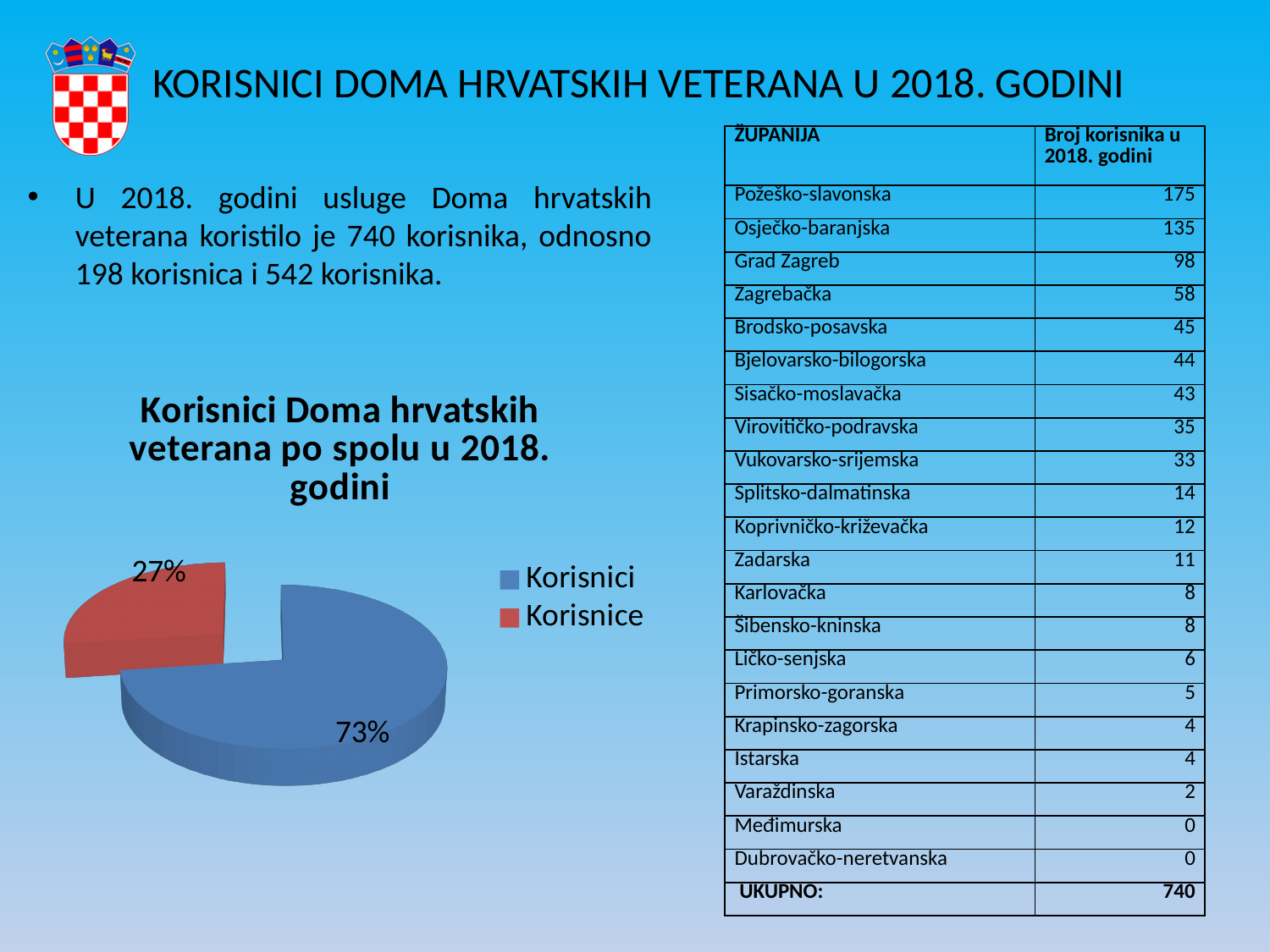
How many entries does the legend of the pie chart list? 2 What colour is the Korisnice slice in the pie chart? red What is the title of the pie chart? Korisnici Doma hrvatskih veterana po spolu u 2018. godini Which is larger in the pie chart, Korisnici or Korisnice? Korisnici Which slice of the pie chart is the smallest? Korisnice What is the difference in percentage points between the Korisnici and Korisnice slices? 46 What kind of chart is shown on the slide? pie chart How many slices does the pie chart have? 2 What share of the pie does Korisnice have? 27% What share of the pie does Korisnici have? 73% Which slice of the pie chart is the largest? Korisnici